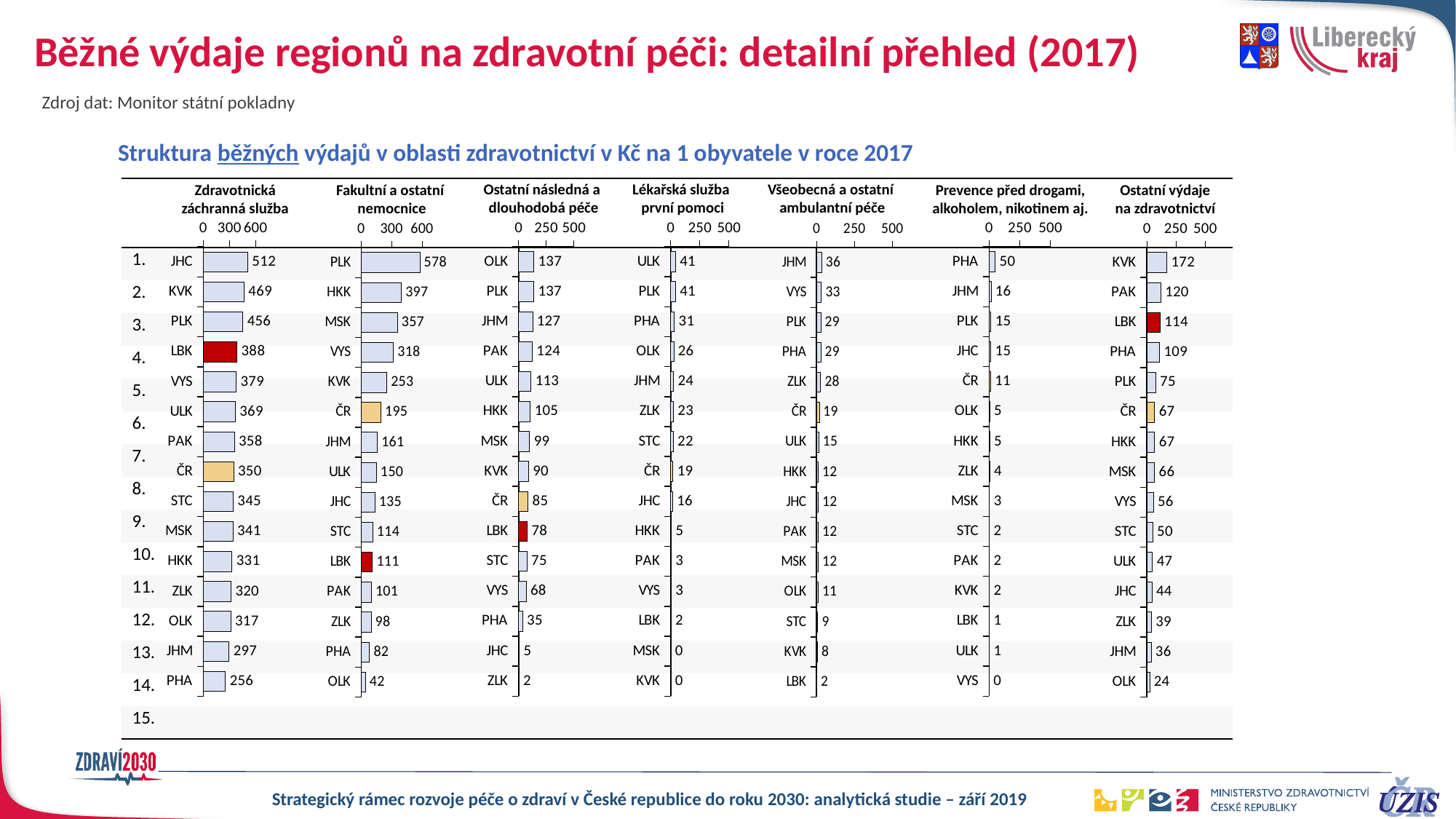
In the 'Fakultní a ostatní nemocnice' chart, what is the value for PLK? 578 In the 'Ostatní následná a dlouhodobá péče' chart, what is the value for LBK? 78 How many bars are plotted in the 'Ostatní výdaje na zdravotnictví' chart? 15 In the 'Fakultní a ostatní nemocnice' chart, what is the difference between PLK and HKK? 181 In the 'Zdravotnická záchranná služba' chart, what is the value for LBK? 388 In the 'Lékařská služba první pomoci' chart, which is larger, the value for PHA or the value for OLK? PHA In the 'Všeobecná a ostatní ambulantní péče' chart, what is the value for JHM? 36 In the 'Prevence před drogami, alkoholem, nikotinem aj.' chart, what is the value for PHA? 50 In the 'Fakultní a ostatní nemocnice' chart, which region has the lowest value? OLK In the 'Ostatní výdaje na zdravotnictví' chart, what is the difference between KVK and PAK? 52 What type of chart is used in the 'Zdravotnická záchranná služba' panel? Bar chart In the 'Zdravotnická záchranná služba' chart, which region has the highest value? JHC